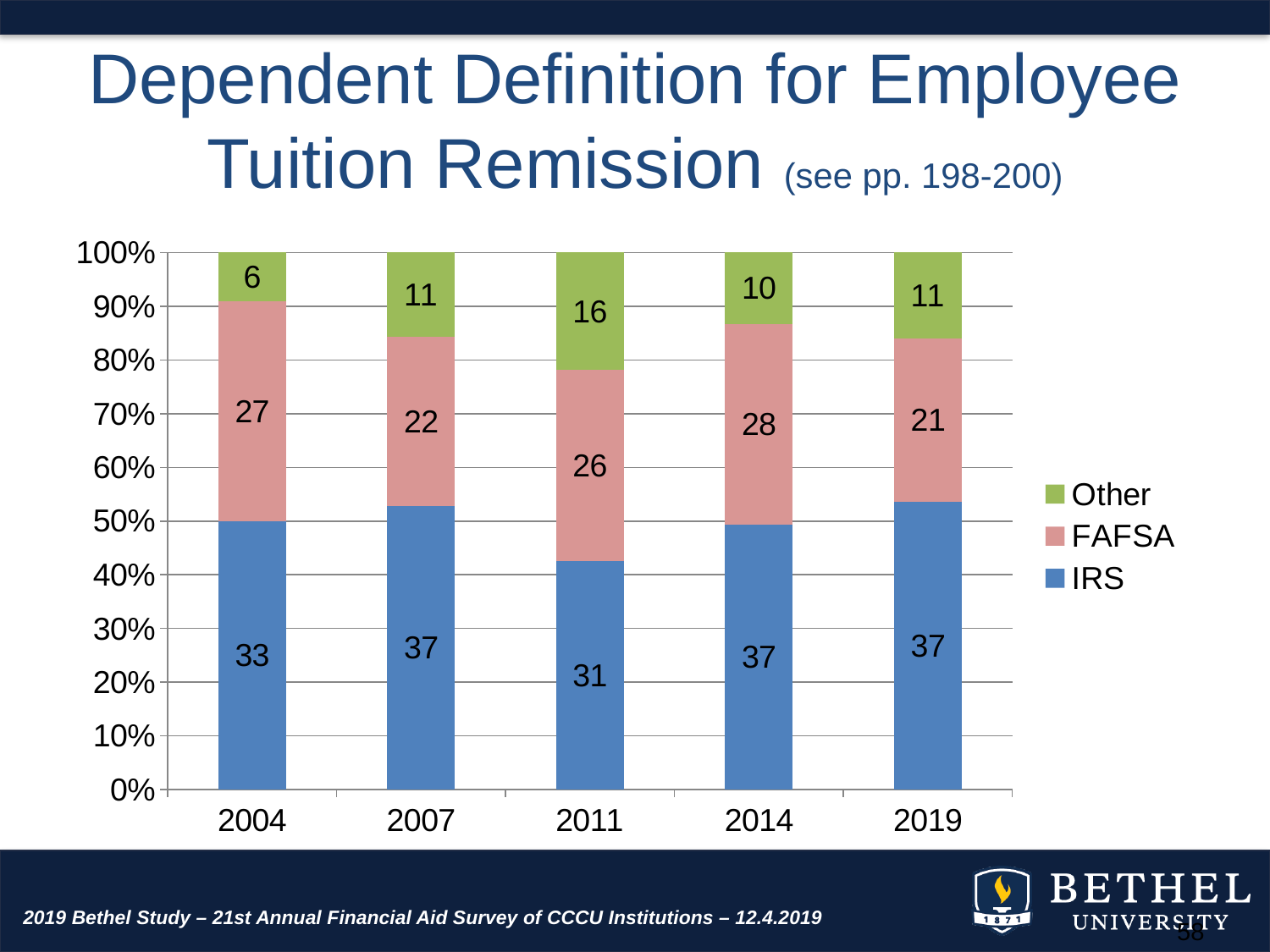
Which is larger, the FAFSA value for 2004 or the FAFSA value for 2007? 2004 What kind of chart is shown on the slide? stacked bar chart How many years are shown on the x axis? 5 What is the Other value for 2004? 6 What is the difference between the FAFSA values for 2014 and 2019? 7 Which legend entry is shown in green? Other In which year is the IRS value lowest? 2011 What is the IRS value for 2011? 31 What is the FAFSA value for 2014? 28 In which year is the Other value highest? 2011 What is the sum of the three labelled values in the 2011 bar? 73 How many series does the legend list? 3